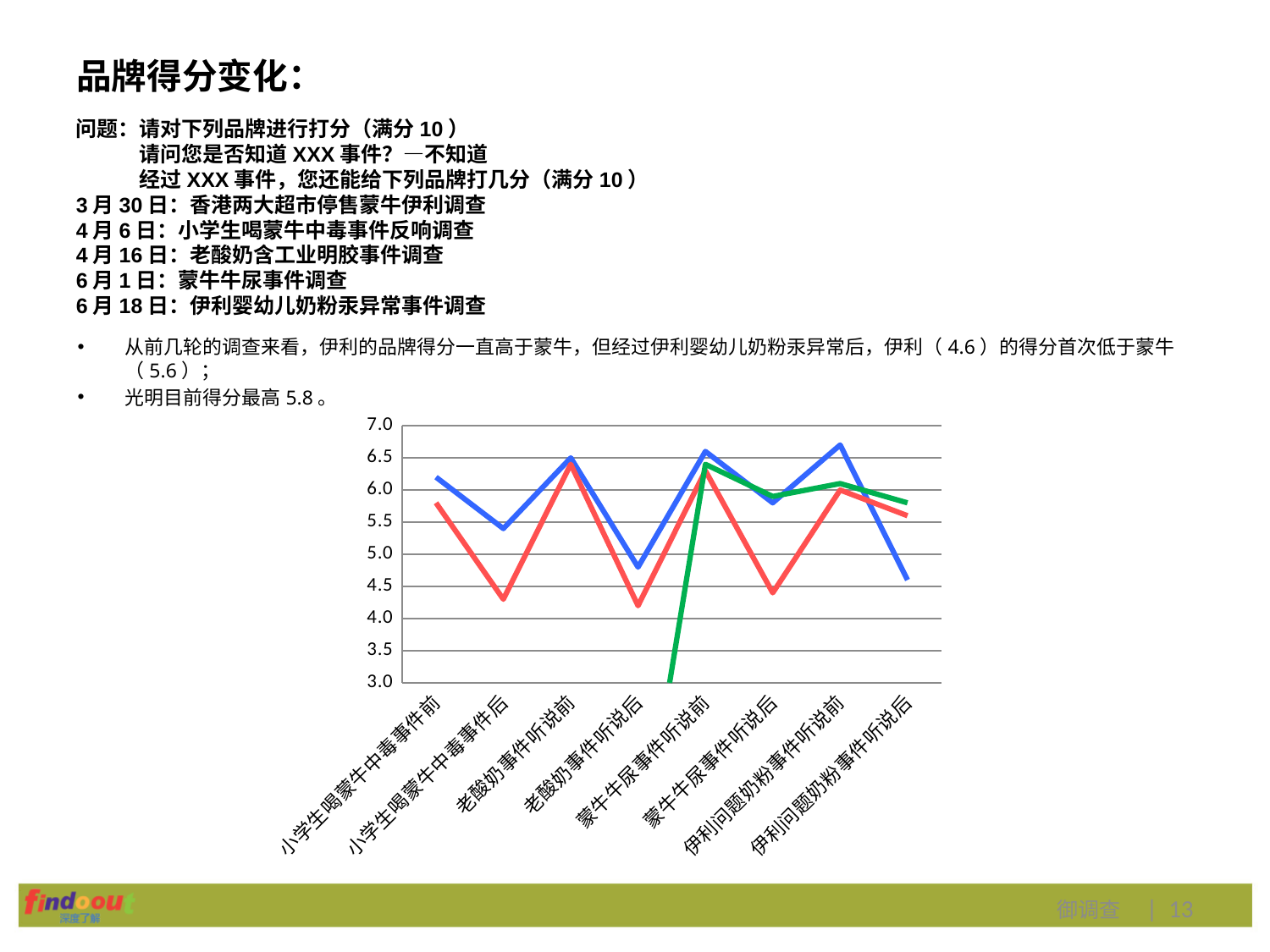
Does the blue line rise or fall from 伊利问题奶粉事件听说前 to 伊利问题奶粉事件听说后? fall How many lines are plotted in the chart? 3 At 小学生喝蒙牛中毒事件前, which line has the higher value, the blue line or the red line? the blue line What kind of chart is shown on the slide? line chart Is the value of the red line at 老酸奶事件听说后 greater or less than 4.5? less How many categories are shown along the x axis of the chart? 8 What is the highest value shown on the chart's y axis? 7.0 Is the value of the blue line at 小学生喝蒙牛中毒事件后 greater or less than 5.0? greater At 伊利问题奶粉事件听说后, which line has the higher value, the blue line or the red line? the red line Is the value of the blue line at 伊利问题奶粉事件听说后 greater or less than 5.0? less At 蒙牛牛尿事件听说后, which line has the higher value, the blue line or the red line? the blue line